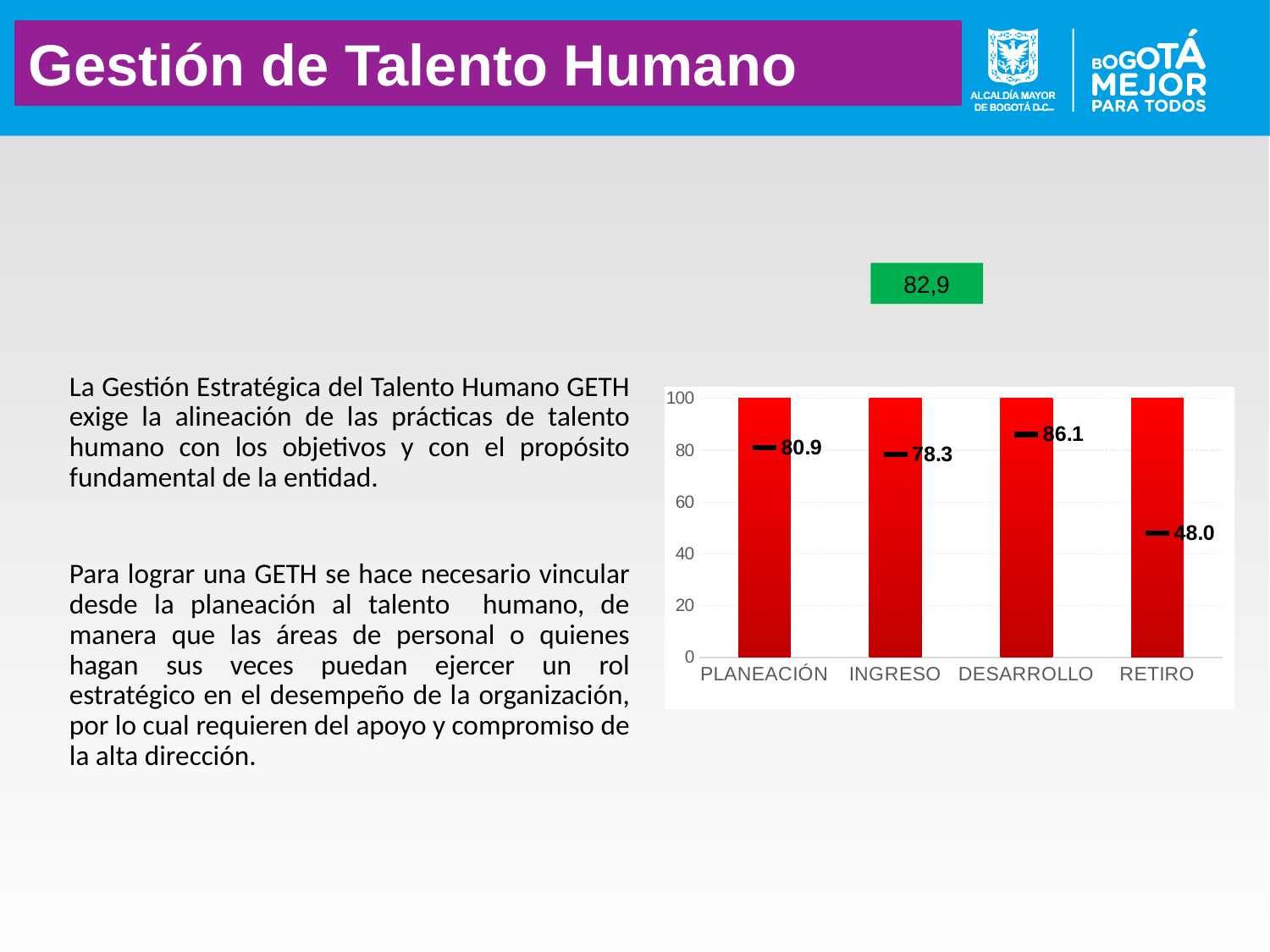
What value is labelled for DESARROLLO in the chart? 86.1 What is the difference between the labelled values for DESARROLLO and RETIRO? 38.1 What value is labelled for PLANEACIÓN in the chart? 80.9 Is the labelled value for RETIRO greater or less than 60? less Which has a larger labelled value, PLANEACIÓN or INGRESO? PLANEACIÓN What value is labelled for RETIRO in the chart? 48.0 Which category has the highest labelled value in the chart? DESARROLLO How many categories are shown on the x axis of the chart? 4 What value is labelled for INGRESO in the chart? 78.3 What type of chart is shown on the slide? bar chart What is the difference between the labelled values for PLANEACIÓN and INGRESO? 2.6 Which category has the lowest labelled value in the chart? RETIRO